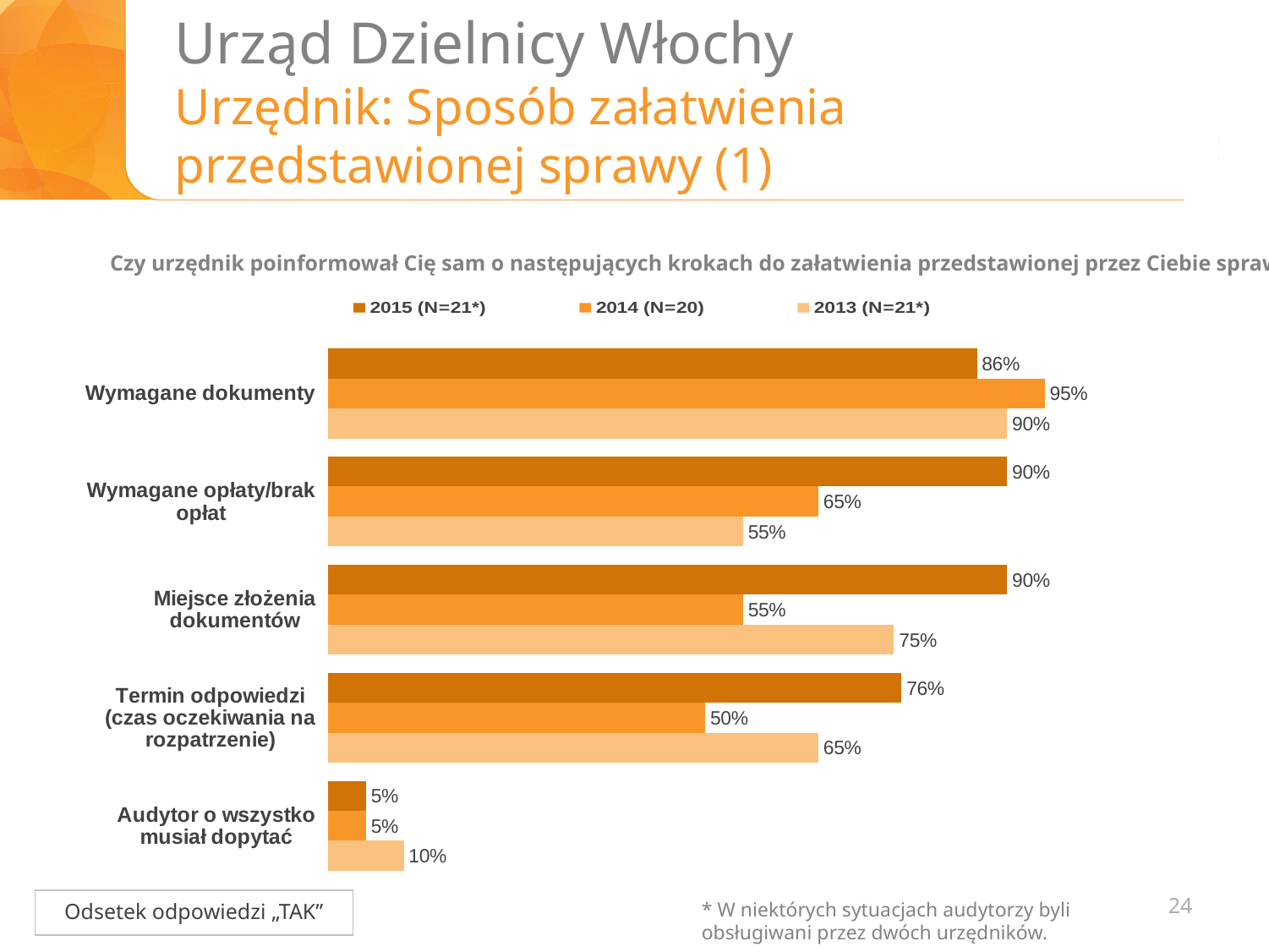
What is the difference between the 2014 (N=20) and 2015 (N=21*) values for "Wymagane dokumenty"? 9 percentage points Which category has the highest value in the 2014 (N=20) series? Wymagane dokumenty What kind of chart is shown on the slide? Bar chart How many categories are shown on the chart? 5 What is the value for "Wymagane dokumenty" in the 2014 (N=20) series? 95% How many series does the legend list? 3 Which category has the lowest value in the 2015 (N=21*) series? Audytor o wszystko musiał dopytać What is the value for "Termin odpowiedzi (czas oczekiwania na rozpatrzenie)" in the 2015 (N=21*) series? 76% What is the difference between the 2015 (N=21*) and 2013 (N=21*) values for "Wymagane opłaty/brak opłat"? 35 percentage points What does the box at the bottom left of the chart say the values represent? Odsetek odpowiedzi „TAK” For "Miejsce złożenia dokumentów", which is larger: the 2014 (N=20) value or the 2013 (N=21*) value? 2013 (N=21*) What is the value for "Miejsce złożenia dokumentów" in the 2013 (N=21*) series? 75%